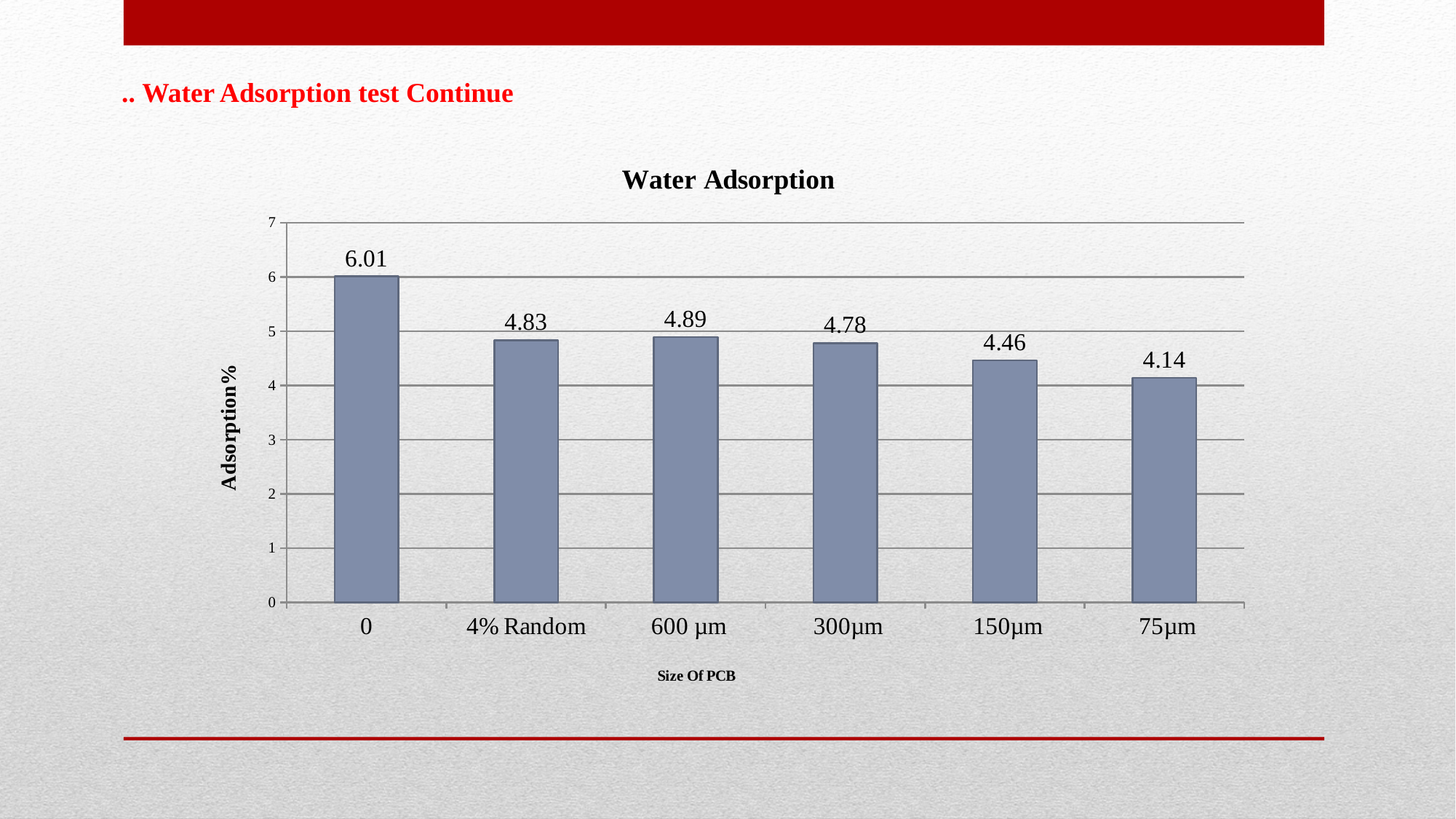
What is the water adsorption value for 75µm? 4.14 What is the water adsorption value for the 0 category? 6.01 What type of chart is shown on the slide? bar chart What is the difference in water adsorption between 300µm and 150µm? 0.32 Which category has the highest water adsorption? 0 Is the water adsorption value for 150µm greater or less than 5? less Which has a higher water adsorption value, 600 µm or 150µm? 600 µm How many categories are shown on the x axis of the chart? 6 What is the water adsorption value for 4% Random? 4.83 What is the difference in water adsorption between the 0 category and 75µm? 1.87 What is the title of the chart? Water Adsorption Which category has the lowest water adsorption? 75µm